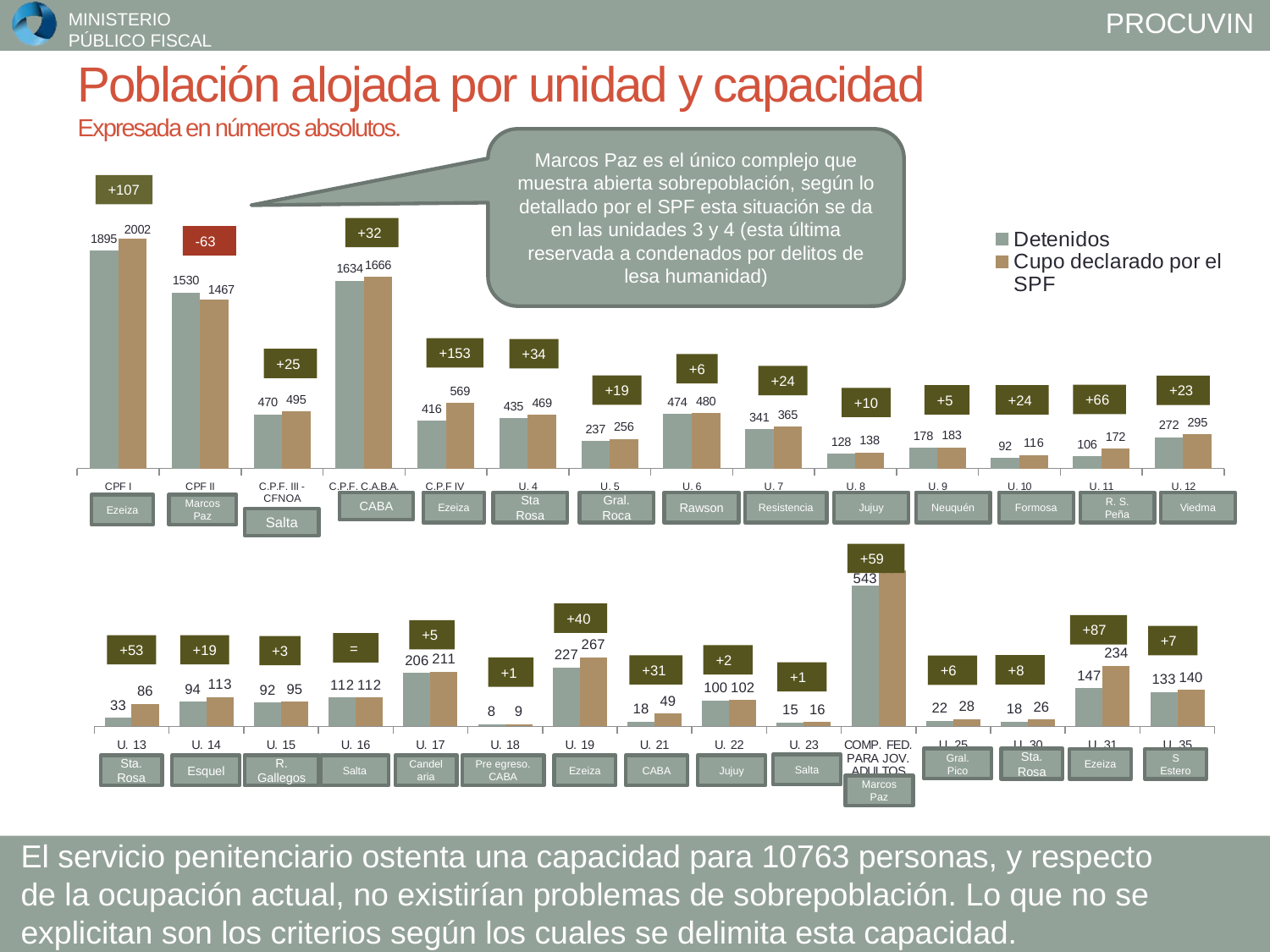
In the bottom chart, which category has the highest Detenidos value? COMP. FED. PARA JOV. ADULTOS In the bottom chart, how many categories are shown on the x axis? 15 In the top chart, which is larger for CPF II: Detenidos or Cupo declarado por el SPF? Detenidos In the top chart, which category has the highest Detenidos value? CPF I In the bottom chart, what is the Detenidos value for U. 19? 227 In the top chart, what is the Detenidos value for CPF I? 1895 In the bottom chart, what is the Cupo declarado por el SPF value for U. 31? 234 In the top chart, which category has the lowest Cupo declarado por el SPF value? U. 10 In the top chart, what is the Cupo declarado por el SPF value for CPF II? 1467 How many series does the legend of the top chart list? 2 In the top chart, what is the difference between the Cupo declarado por el SPF and Detenidos values for C.P.F IV? 153 What kind of chart is the bottom chart? Bar chart